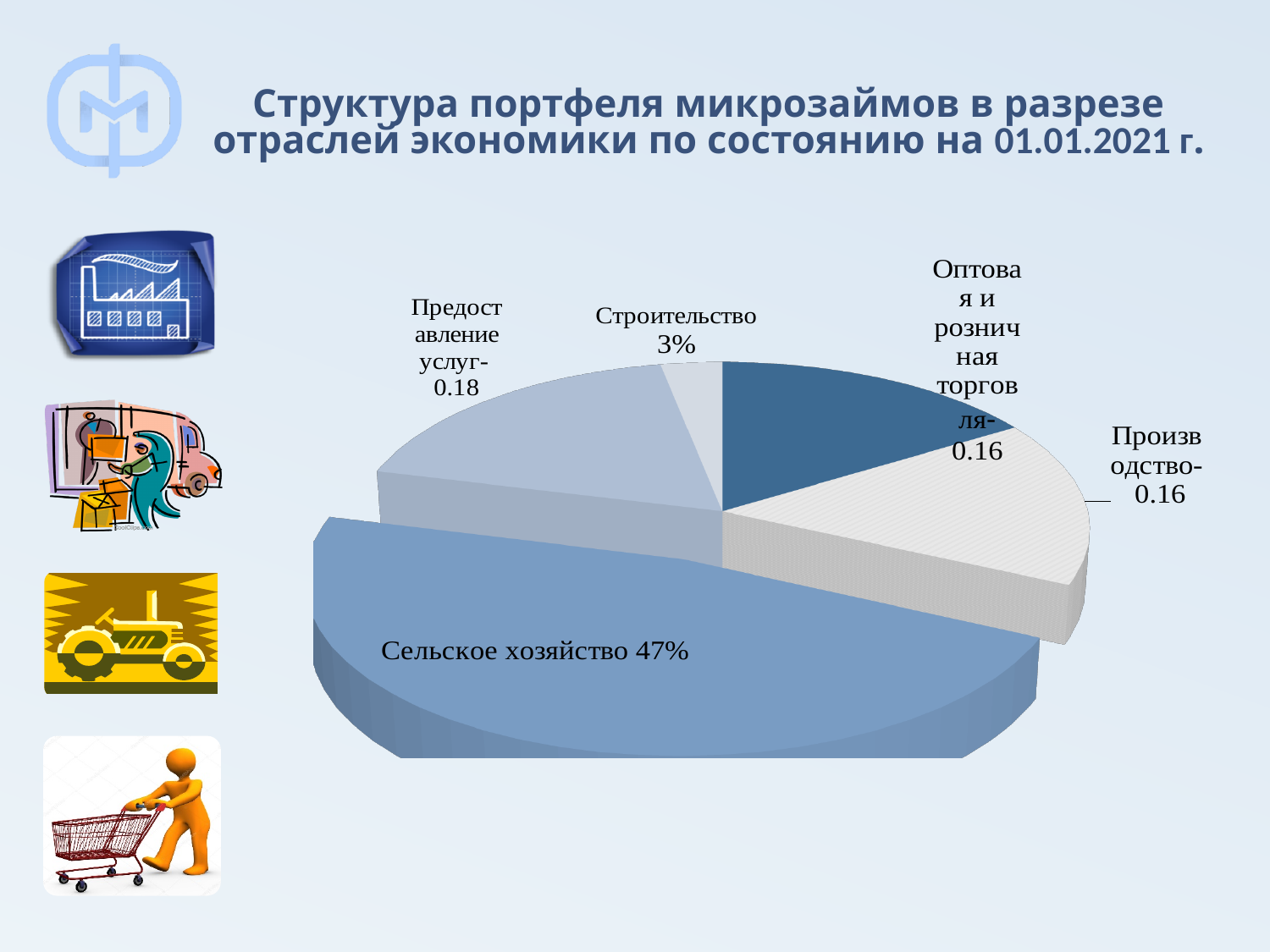
What is the difference between the values for Предоставление услуг and Производство? 0.02 What value is shown for Производство? 0.16 Which sector has the smallest slice of the pie? Строительство What kind of chart is shown on the slide? Pie chart What is the title of the slide? Структура портфеля микрозаймов в разрезе отраслей экономики по состоянию на 01.01.2021 г. What share of the pie is labelled for Сельское хозяйство? 47% How many sectors (slices) are shown in the pie chart? 5 Which is larger, the slice for Сельское хозяйство or the slice for Предоставление услуг? Сельское хозяйство What value is shown for Строительство? 3% Which sector has the largest slice of the pie? Сельское хозяйство What value is shown for Оптовая и розничная торговля? 0.16 What value is shown for Предоставление услуг? 0.18